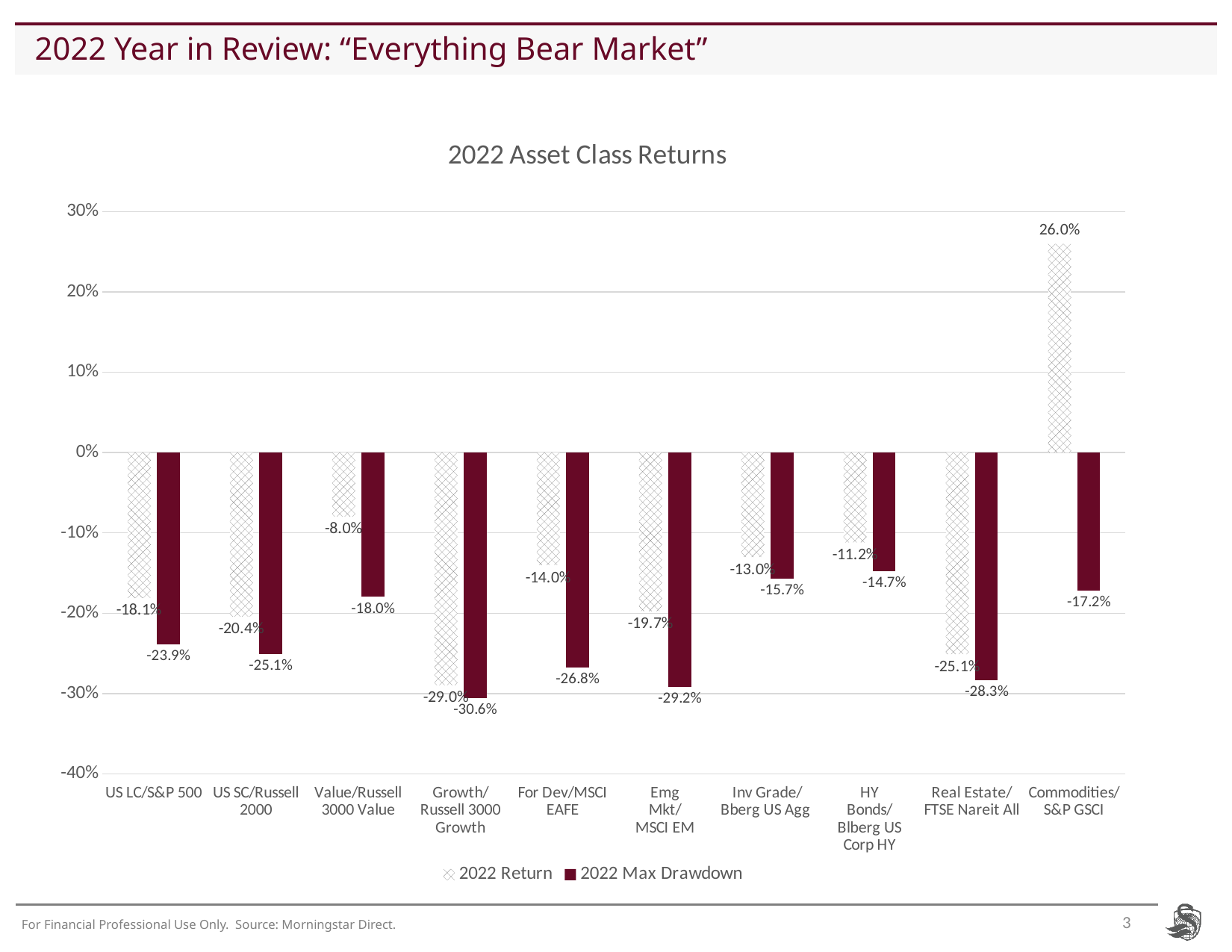
Which asset class has the highest 2022 Return? Commodities/S&P GSCI What is the title of the chart? 2022 Asset Class Returns What is the 2022 Return for Value/Russell 3000 Value? -8.0% What type of chart is shown on the slide? Bar chart What is the 2022 Max Drawdown for Emg Mkt/MSCI EM? -29.2% What is the difference between the 2022 Return and the 2022 Max Drawdown for For Dev/MSCI EAFE? 12.8 percentage points What is the 2022 Max Drawdown for Growth/Russell 3000 Growth? -30.6% Which has a higher 2022 Return, US LC/S&P 500 or US SC/Russell 2000? US LC/S&P 500 Which asset class has the lowest 2022 Max Drawdown? Growth/Russell 3000 Growth What is the 2022 Return for Commodities/S&P GSCI? 26.0% How many asset classes are shown on the x axis? 10 How many series does the legend list? 2